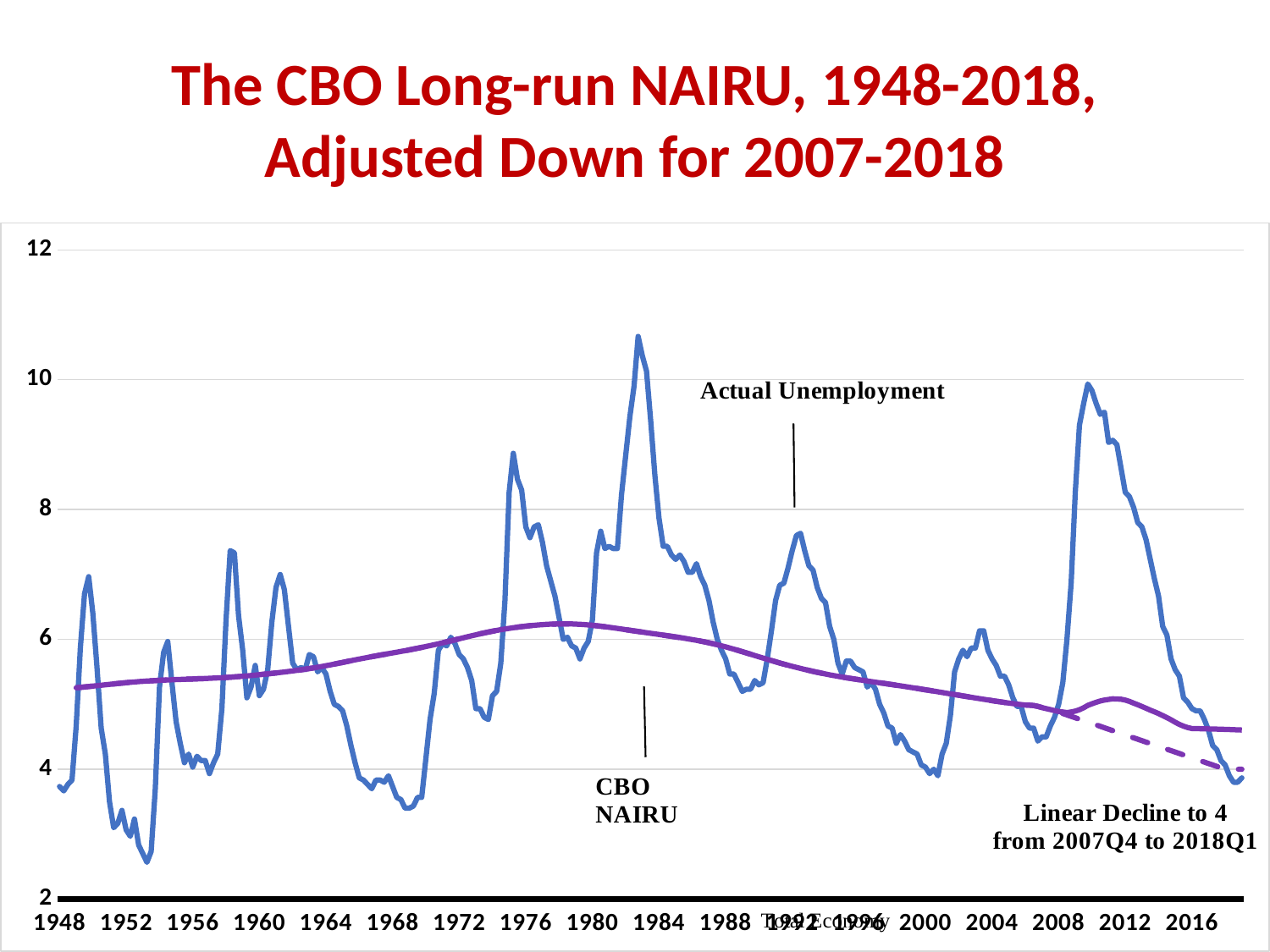
Does the CBO NAIRU line rise or fall between 1980 and 2016? fall Is the peak of Actual Unemployment around 1992 greater or less than 8? less What kind of chart is shown on the slide? line chart What does the dashed purple line at the right of the chart represent? Linear Decline to 4 from 2007Q4 to 2018Q1 Is the value of the CBO NAIRU line in 1948 greater or less than 6? less Is the lowest value of Actual Unemployment in the early 1950s greater or less than 4? less What is the title of the chart? The CBO Long-run NAIRU, 1948-2018, Adjusted Down for 2007-2018 In which decade does Actual Unemployment reach its highest value? 1980s How many year labels are shown on the x axis? 18 In which decade does Actual Unemployment reach its lowest value? 1950s